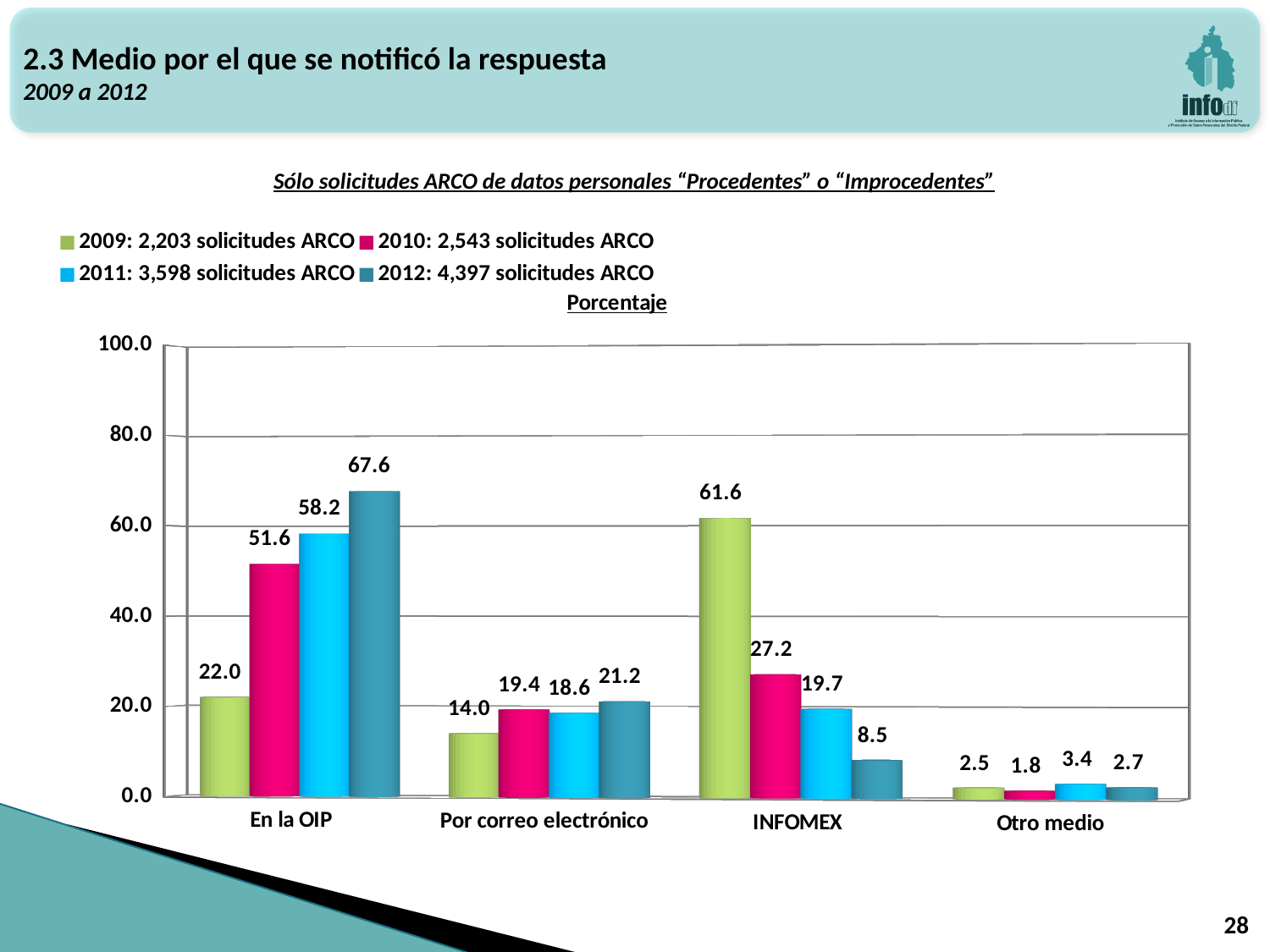
What is the value for 2009 in the 'INFOMEX' category? 61.6 Which is larger in the 'INFOMEX' category: the 2010 value or the 2011 value? 2010 How many categories are shown on the x axis? 4 What is the difference between the 2012 and 2009 values in the 'En la OIP' category? 45.6 What kind of chart is shown on the slide? Bar chart What is the value for 2010 in the 'Otro medio' category? 1.8 Which category has the highest value for the 2009 series? INFOMEX What is the value for 2012 in the 'En la OIP' category? 67.6 Is the value for 2011 in the 'En la OIP' category greater or less than 40.0? greater How many series does the legend list? 4 What is the value for 2011 in the 'Por correo electrónico' category? 18.6 Which category has the lowest value for the 2012 series? Otro medio